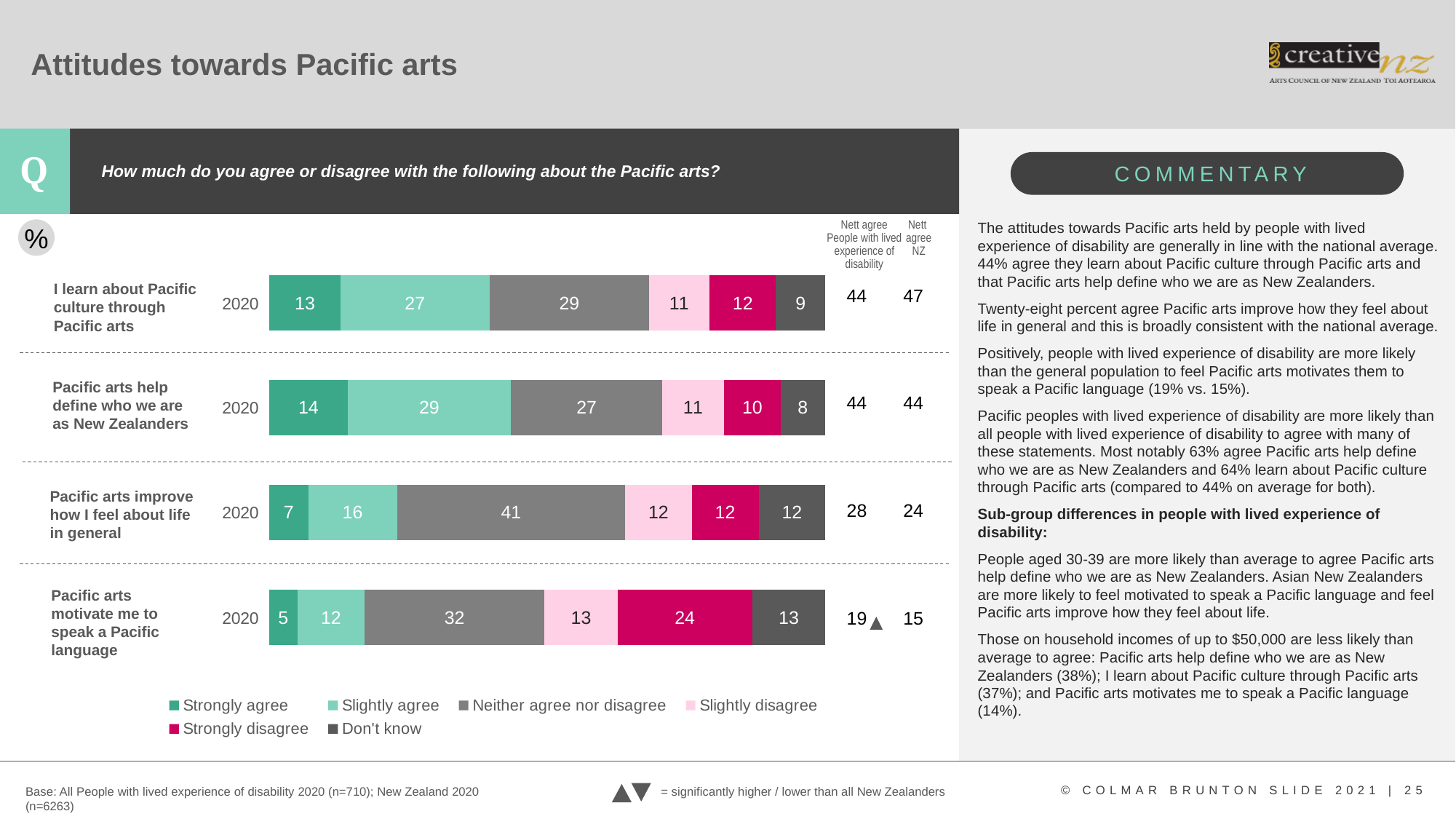
How many statements are shown in the chart? 4 What kind of chart is shown on the slide? Stacked bar chart Which has the larger 'Strongly disagree' value: 'Pacific arts motivate me to speak a Pacific language' or 'I learn about Pacific culture through Pacific arts'? Pacific arts motivate me to speak a Pacific language What percentage strongly agree that Pacific arts help define who we are as New Zealanders? 14 What is the difference in 'Slightly agree' between 'Pacific arts help define who we are as New Zealanders' and 'I learn about Pacific culture through Pacific arts'? 2 Which statement has the lowest 'Strongly agree' value? Pacific arts motivate me to speak a Pacific language What percentage strongly disagree that Pacific arts motivate them to speak a Pacific language? 24 How many series does the legend list? 6 What is the 'Neither agree nor disagree' value for 'Pacific arts improve how I feel about life in general'? 41 Which statement has a triangle marker next to its Nett agree figure for people with lived experience of disability? Pacific arts motivate me to speak a Pacific language Which statement has the highest 'Neither agree nor disagree' value? Pacific arts improve how I feel about life in general What is the Nett agree NZ figure for 'Pacific arts improve how I feel about life in general'? 24